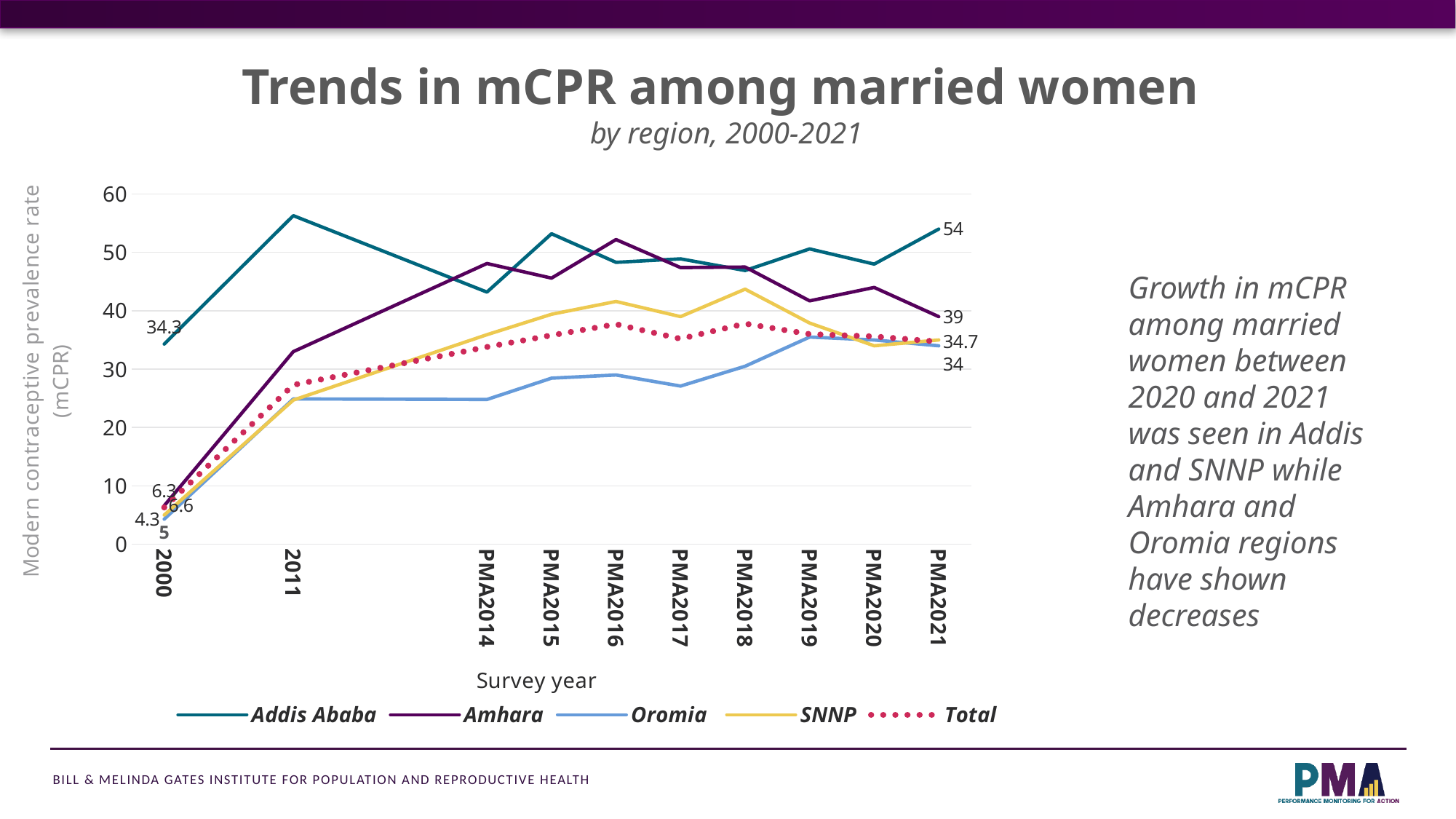
Is the value for Oromia at PMA2014 greater or less than 30? less What type of chart is shown on the slide? line chart What is the mCPR value for Amhara at PMA2021? 39 What is the mCPR value for Addis Ababa in 2000? 34.3 Which series is drawn as a dotted line? Total Which region has the highest mCPR at PMA2021? Addis Ababa How many series does the legend list? 5 What is the difference between the Addis Ababa and Amhara values at PMA2021? 15 Which region has the highest mCPR in 2000? Addis Ababa Does the Amhara line rise or fall from PMA2020 to PMA2021? fall How many survey years are shown on the x axis? 10 What is the mCPR value for Addis Ababa at PMA2021? 54